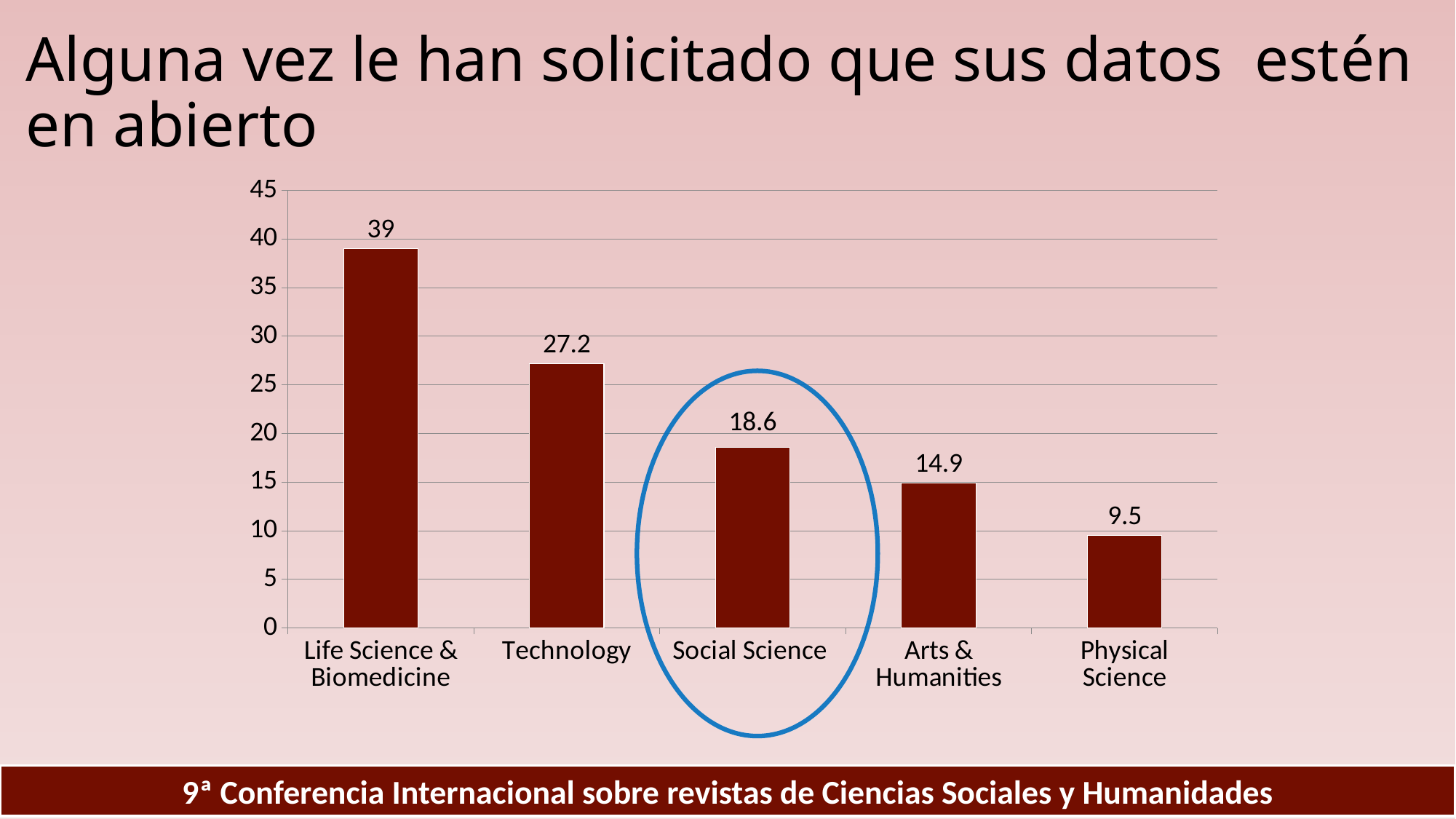
What is the value for Physical Science? 9.5 Which is larger, the value for Social Science or the value for Arts & Humanities? Social Science What is the value for Social Science? 18.6 Which category is circled in blue on the chart? Social Science Which category has the lowest value? Physical Science How many categories are shown on the x axis? 5 What is the value for Arts & Humanities? 14.9 What is the value for Technology? 27.2 What kind of chart is shown on the slide? Bar chart What is the value for Life Science & Biomedicine? 39 What is the difference between the values for Life Science & Biomedicine and Technology? 11.8 Which category has the highest value? Life Science & Biomedicine